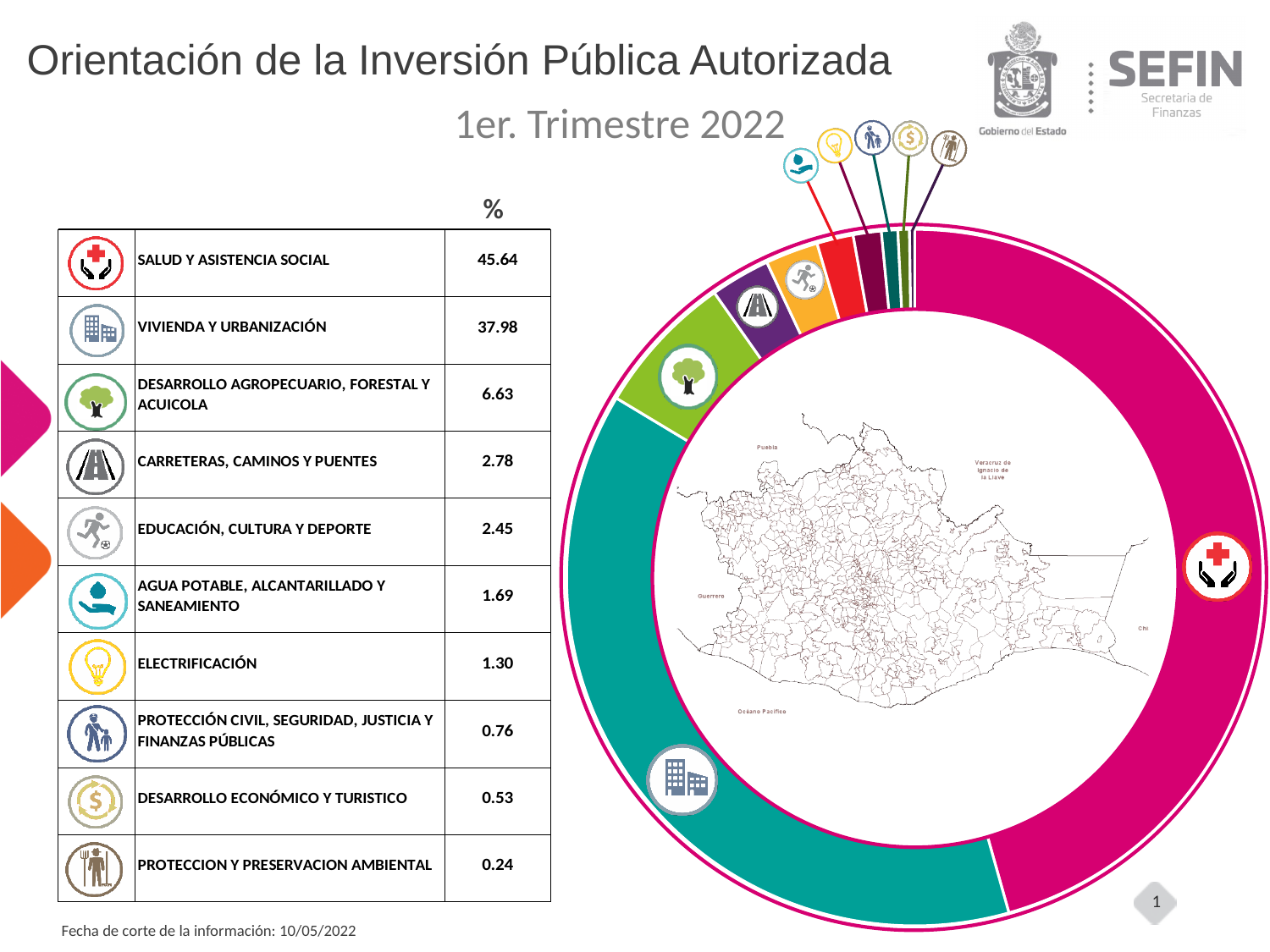
How many categories are listed in the table accompanying the chart? 10 What percentage is listed for CARRETERAS, CAMINOS Y PUENTES? 2.78 Which has a larger share: DESARROLLO AGROPECUARIO, FORESTAL Y ACUICOLA or EDUCACIÓN, CULTURA Y DEPORTE? DESARROLLO AGROPECUARIO, FORESTAL Y ACUICOLA What percentage is listed for ELECTRIFICACIÓN? 1.30 What is the difference in percentage points between SALUD Y ASISTENCIA SOCIAL and VIVIENDA Y URBANIZACIÓN? 7.66 What percentage is listed for VIVIENDA Y URBANIZACIÓN? 37.98 What is the combined percentage of SALUD Y ASISTENCIA SOCIAL and VIVIENDA Y URBANIZACIÓN? 83.62 What kind of chart is shown on the slide? Pie (donut) chart What is the title of the slide? Orientación de la Inversión Pública Autorizada Which category has the largest share of the authorized public investment? SALUD Y ASISTENCIA SOCIAL According to the table on the slide, what percentage of the authorized public investment goes to SALUD Y ASISTENCIA SOCIAL? 45.64 Which category has the smallest share of the authorized public investment? PROTECCION Y PRESERVACION AMBIENTAL